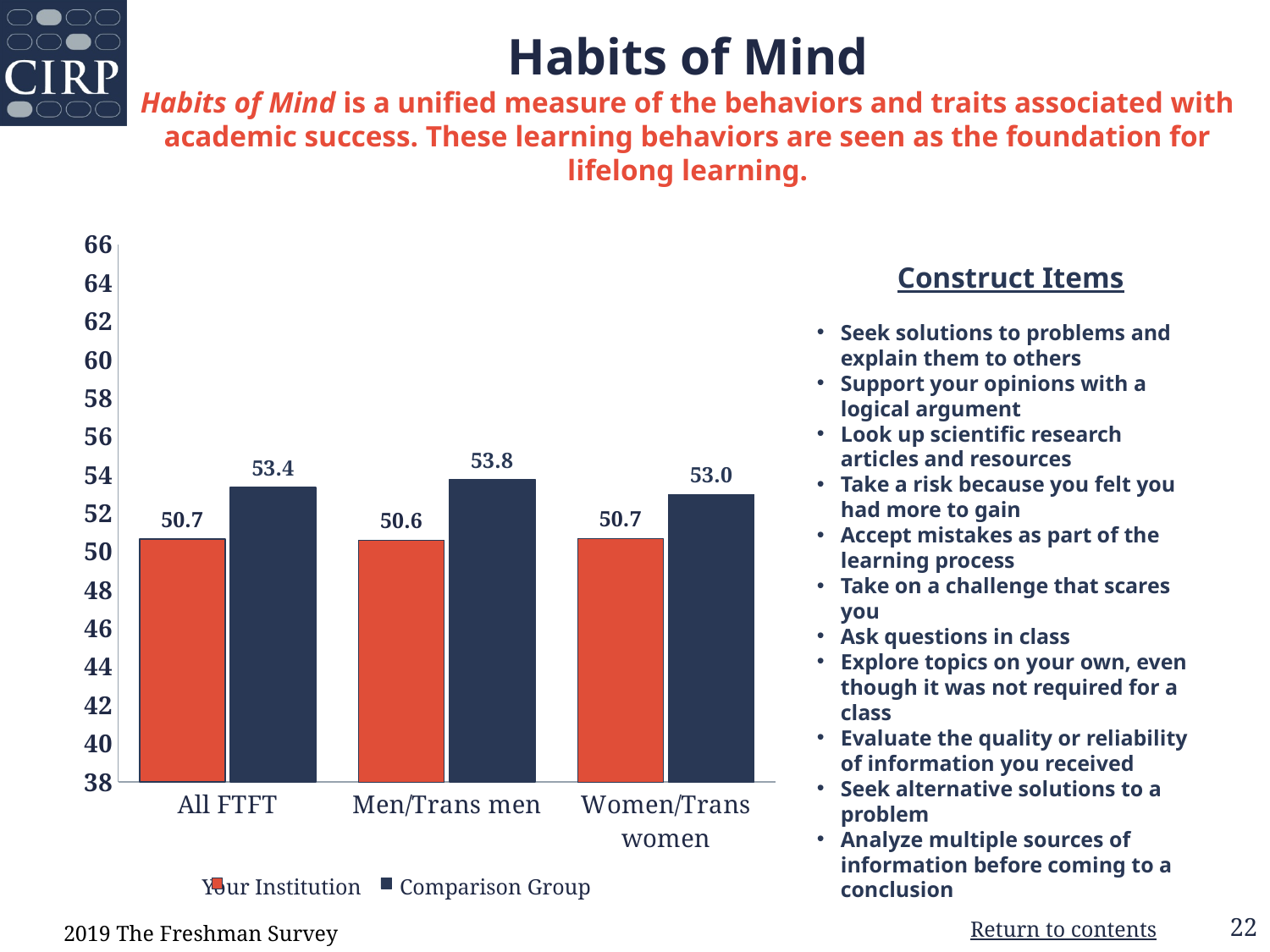
What is the Your Institution value for Men/Trans men? 50.6 What is the Comparison Group value for Women/Trans women? 53.0 Which category has the lowest Comparison Group value? Women/Trans women How many series does the legend list? 2 Which category has the highest Comparison Group value? Men/Trans men What kind of chart is shown on the slide? Bar chart What is the Comparison Group value for Men/Trans men? 53.8 How many categories are shown on the x axis? 3 What is the Your Institution value for All FTFT? 50.7 For Women/Trans women, which is larger: Your Institution or Comparison Group? Comparison Group What is the difference between the Comparison Group and Your Institution values for Men/Trans men? 3.2 What is the difference between the Comparison Group and Your Institution values for All FTFT? 2.7